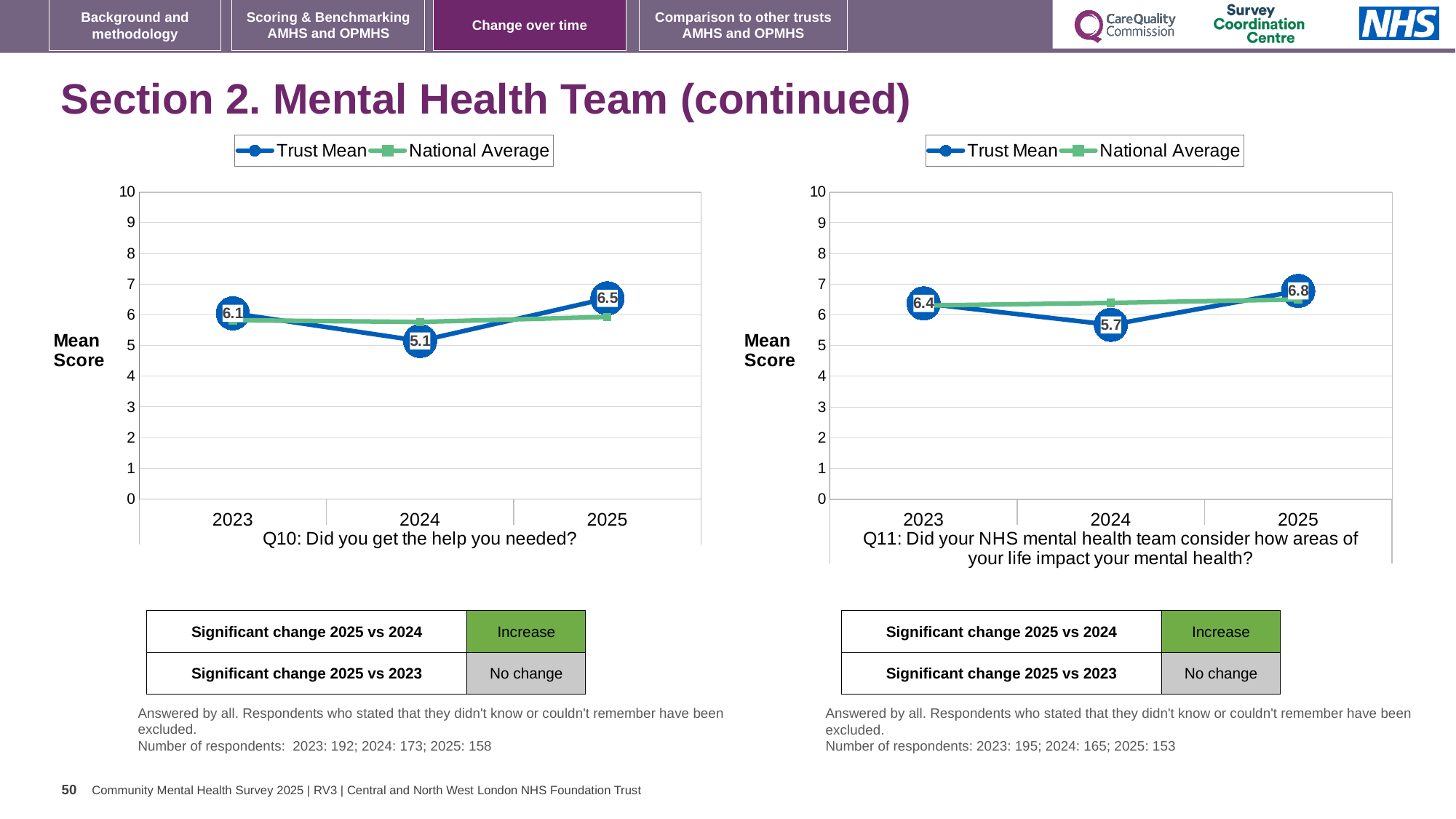
On the Q11 chart, what is the Trust Mean score for 2023? 6.4 On the Q10 chart, what is the difference between the Trust Mean scores for 2025 and 2024? 1.4 On the Q11 chart, what is the difference between the Trust Mean scores for 2023 and 2024? 0.7 On the Q11 chart, is the Trust Mean score for 2024 higher or lower than the Trust Mean score for 2023? lower On the Q10 chart, what is the Trust Mean score for 2025? 6.5 On the Q10 chart, is the National Average for 2024 greater or less than 5? greater On the Q10 chart, which year has the lowest Trust Mean score? 2024 On the Q10 chart, what is the Trust Mean score for 2024? 5.1 On the Q11 chart, which year has the highest Trust Mean score? 2025 On the Q11 chart, what is the Trust Mean score for 2025? 6.8 How many series does the legend of the Q11 chart list? 2 What type of chart is used for Q10: Did you get the help you needed? Line chart